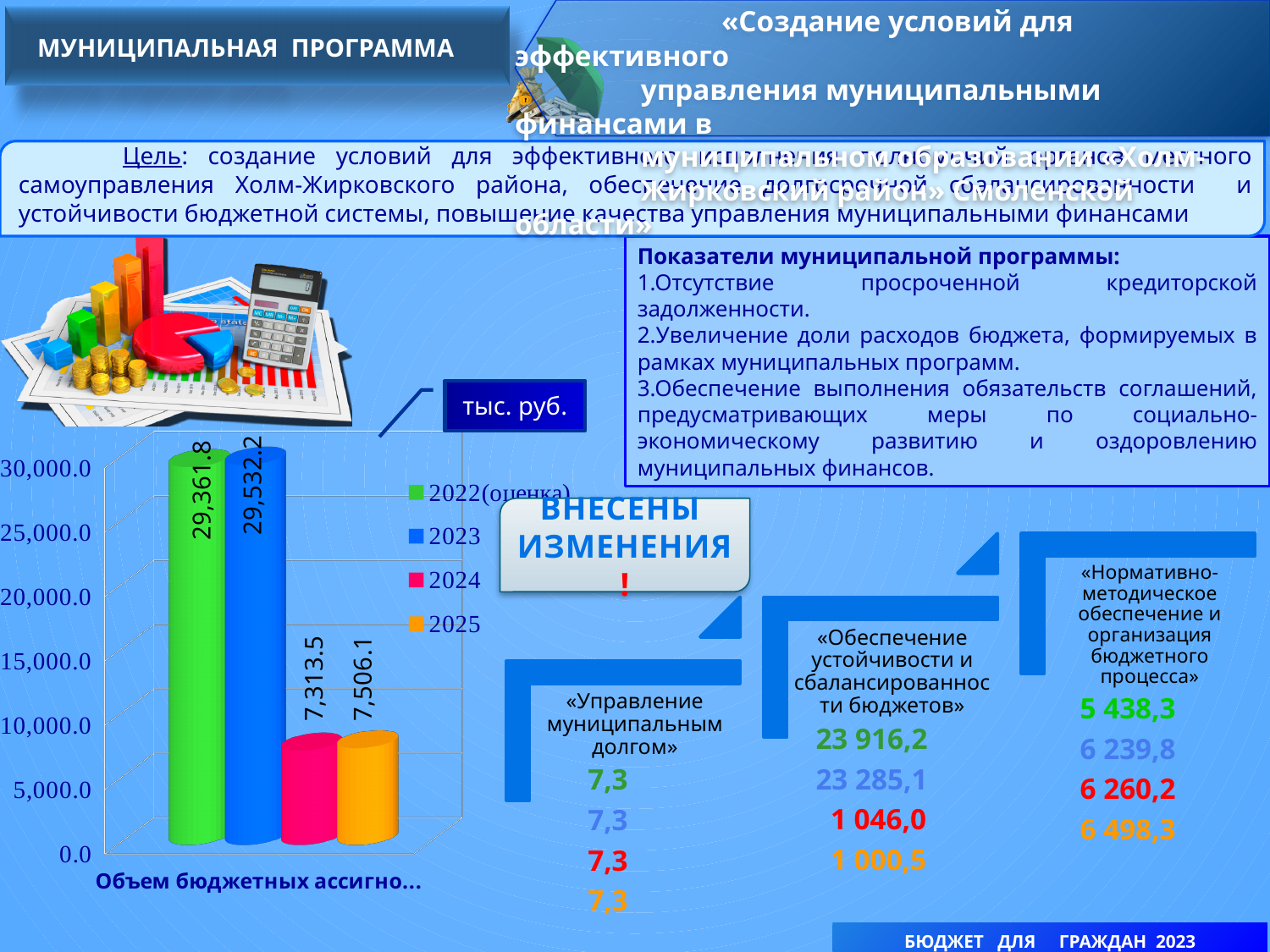
What is the value for the 2022(оценка) series in the bar chart? 29,361.8 What unit is indicated for the values in the bar chart? тыс. руб. What kind of chart is shown on the slide? bar chart What is the value for the 2025 series in the bar chart? 7,506.1 How many series does the legend of the bar chart list? 4 What is the value for the 2023 series in the bar chart? 29,532.2 What is the difference between the 2025 value and the 2024 value in the bar chart? 192.6 Which is larger in the bar chart, the 2024 value or the 2025 value? 2025 Which series has the lowest value in the bar chart? 2024 What is the value for the 2024 series in the bar chart? 7,313.5 Which series has the highest value in the bar chart? 2023 What is the difference between the 2023 value and the 2022(оценка) value in the bar chart? 170.4